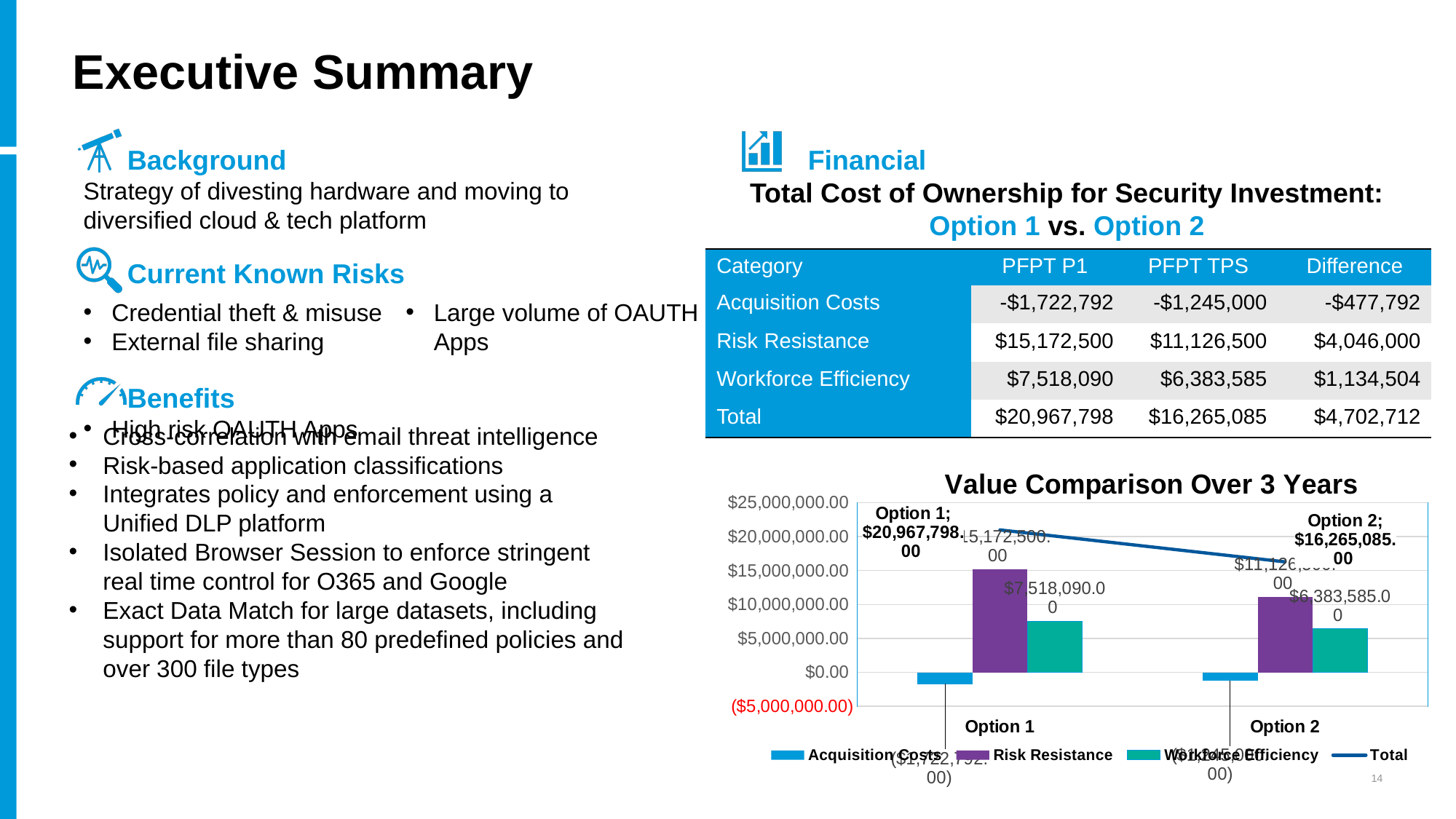
In the 'Value Comparison Over 3 Years' chart, what is the Workforce Efficiency value for Option 2? $6,383,585.00 In the 'Value Comparison Over 3 Years' chart, does the Total line rise or fall from Option 1 to Option 2? falls In the 'Value Comparison Over 3 Years' chart, what is the Total value for Option 1? $20,967,798.00 In the 'Value Comparison Over 3 Years' chart, what is the Workforce Efficiency value for Option 1? $7,518,090.00 In the 'Value Comparison Over 3 Years' chart, which series is drawn as a line rather than bars? Total What kind of chart is 'Value Comparison Over 3 Years'? bar chart with a line How many categories are shown on the x axis of the 'Value Comparison Over 3 Years' chart? 2 In the 'Value Comparison Over 3 Years' chart, what is the Total value for Option 2? $16,265,085.00 In the 'Value Comparison Over 3 Years' chart, is the Risk Resistance value for Option 2 greater or less than $10,000,000.00? greater In the 'Value Comparison Over 3 Years' chart, is the Acquisition Costs value for Option 1 greater or less than $0.00? less How many series does the legend of the 'Value Comparison Over 3 Years' chart list? 4 In the 'Value Comparison Over 3 Years' chart, which option has the larger Risk Resistance bar, Option 1 or Option 2? Option 1